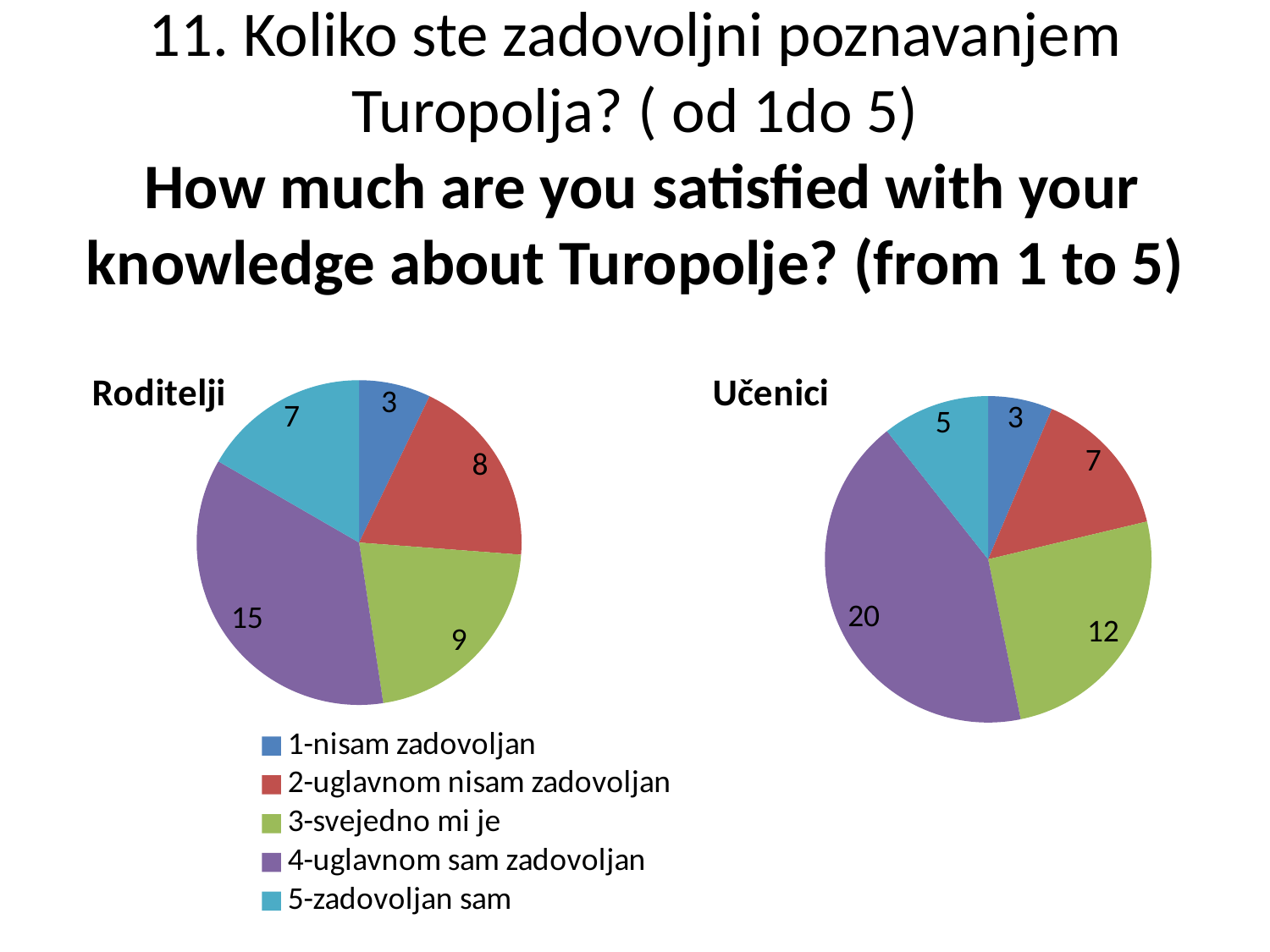
In the Roditelji chart, which category has the smallest slice? 1-nisam zadovoljan In the Učenici chart, what is the value for 3-svejedno mi je? 12 In the Roditelji chart, which is larger: the value for 2-uglavnom nisam zadovoljan or the value for 3-svejedno mi je? 3-svejedno mi je What is the total of all slices in the Roditelji chart? 42 Which colour represents 5-zadovoljan sam in the legend? teal (light blue) In the Učenici chart, what is the difference between the values for 4-uglavnom sam zadovoljan and 3-svejedno mi je? 8 In the Roditelji chart, what is the value for 5-zadovoljan sam? 7 How many slices does the Učenici pie chart have? 5 How many entries does the legend list? 5 In the Roditelji chart, what is the value for 4-uglavnom sam zadovoljan? 15 What type of chart is the Roditelji chart? pie chart In the Učenici chart, which category has the largest slice? 4-uglavnom sam zadovoljan